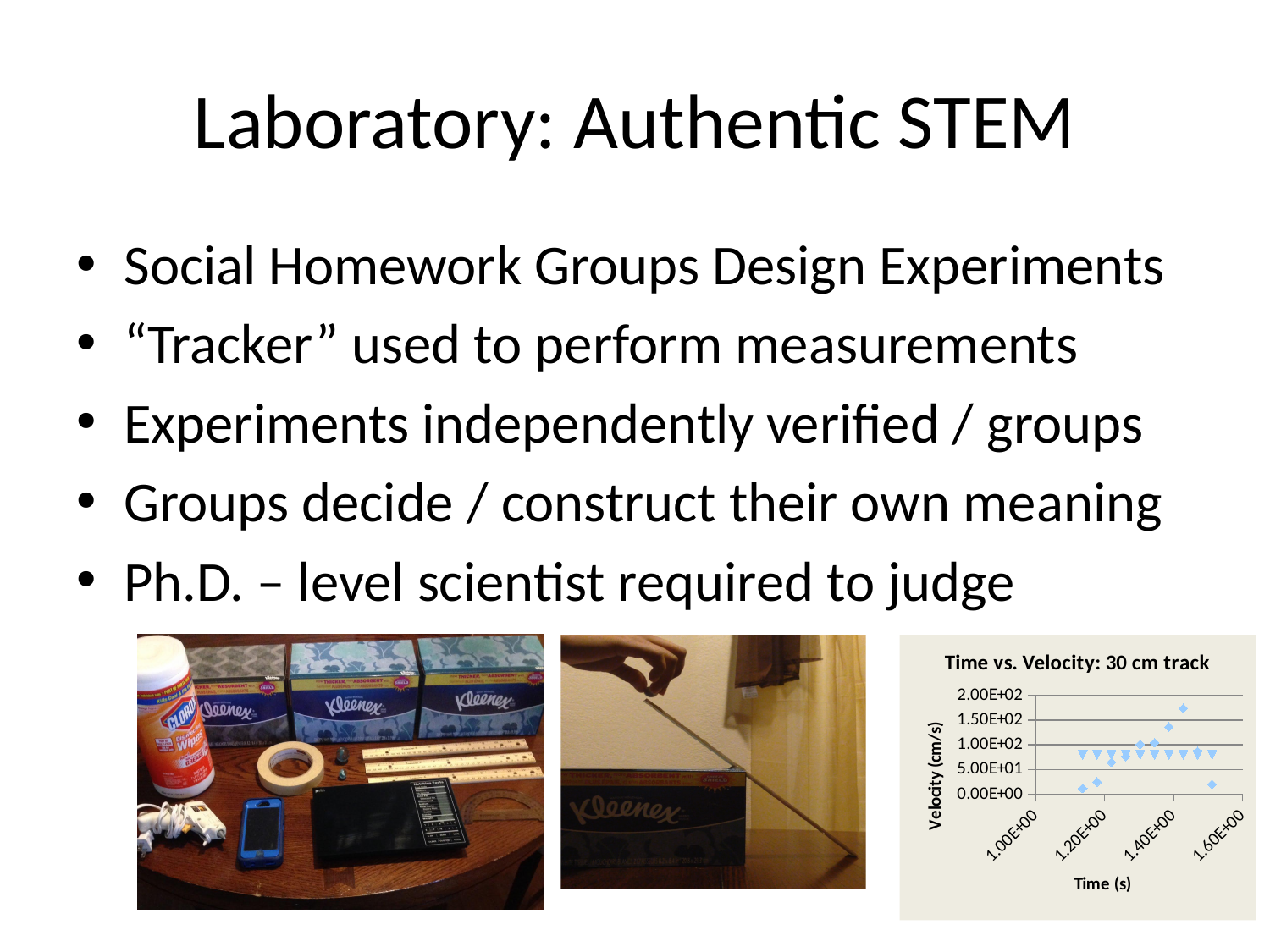
In the chart, are all plotted points at times greater or less than 1.60E+00 s? less What is the label of the vertical axis of the chart? Velocity (cm/s) In the chart, is the lowest plotted velocity greater or less than 5.00E+01 cm/s? less In the chart, does the highest velocity point occur at a time greater or less than 1.40E+00 s? greater What is the title of the chart on the slide? Time vs. Velocity: 30 cm track What kind of chart is shown at the bottom right of the slide? scatter chart